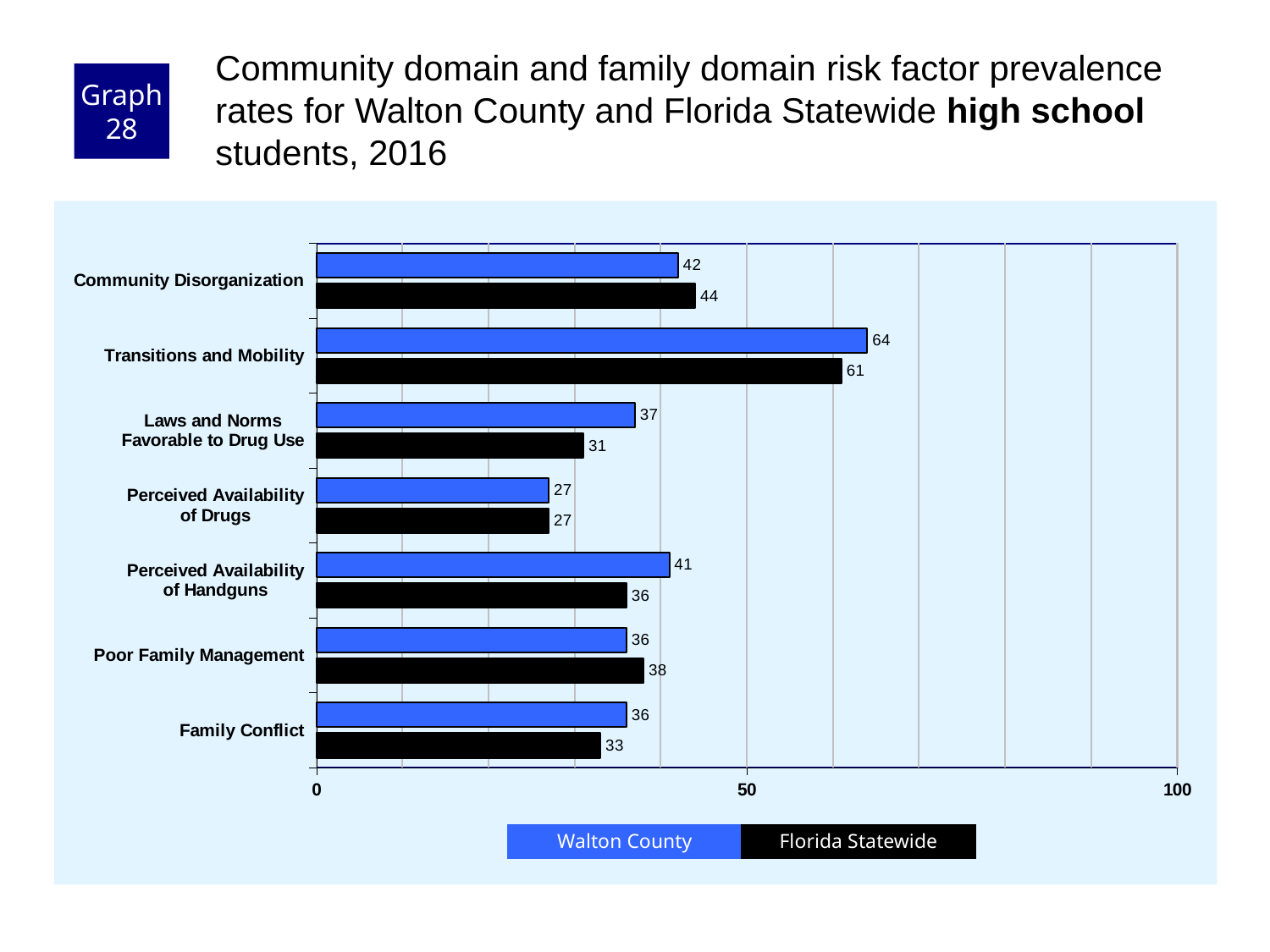
What is the Walton County value for Transitions and Mobility? 64 What is the difference between the Walton County and Florida Statewide values for Perceived Availability of Handguns? 5 Which colour represents Florida Statewide in the chart? black Which is larger for Community Disorganization: the Walton County value or the Florida Statewide value? Florida Statewide What kind of chart is shown on the slide? bar chart What is the Florida Statewide value for Poor Family Management? 38 Is the Walton County value for Transitions and Mobility greater or less than 50? greater What is the Florida Statewide value for Laws and Norms Favorable to Drug Use? 31 How many series does the legend list? 2 How many risk factor categories are shown on the chart? 7 Which risk factor has the lowest Florida Statewide value? Perceived Availability of Drugs Which risk factor has the highest Walton County value? Transitions and Mobility